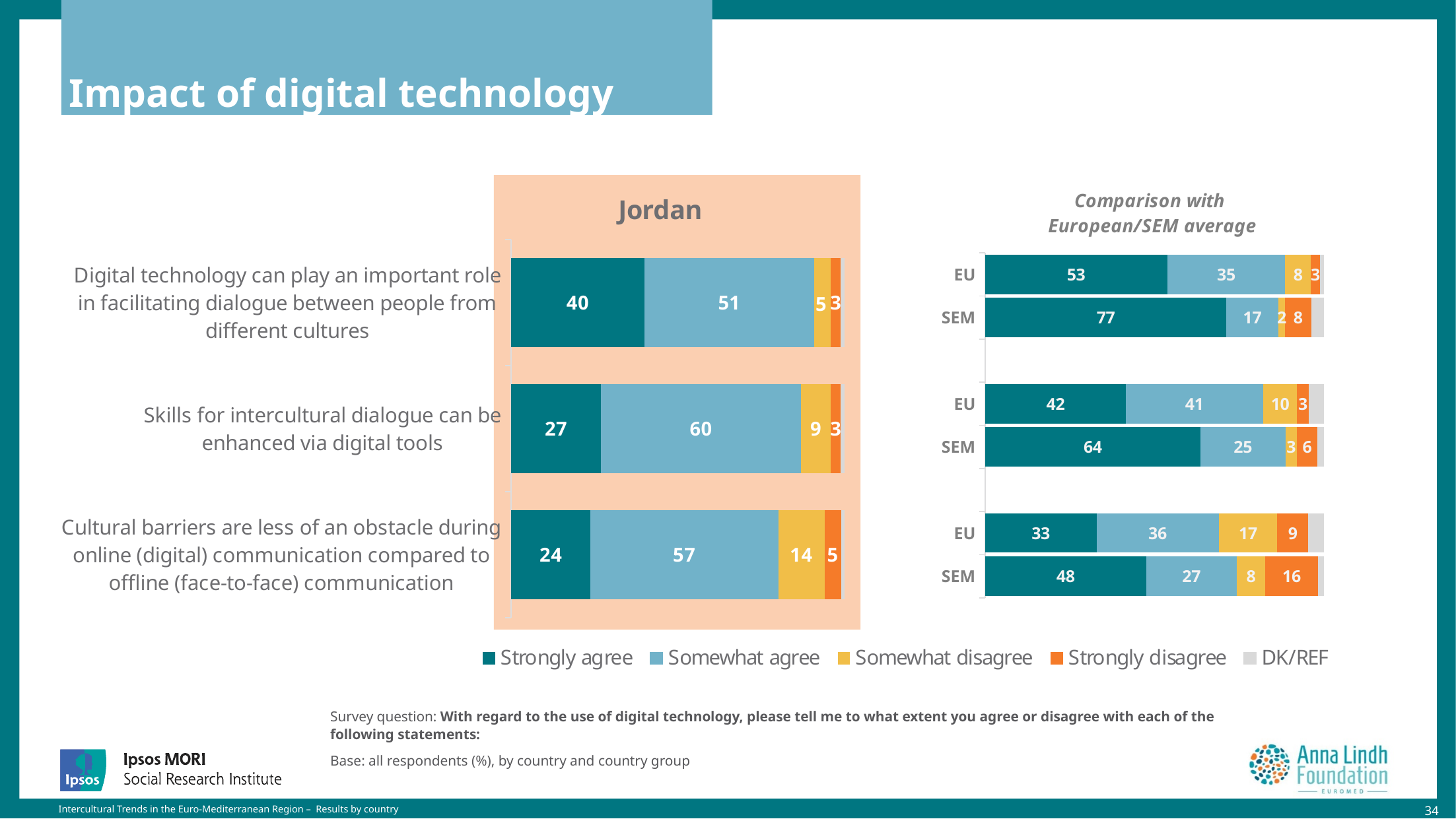
In the Jordan chart, what is the Somewhat disagree value for the statement about cultural barriers being less of an obstacle during online communication? 14 In the Jordan chart, what percentage strongly agree that digital technology can play an important role in facilitating dialogue between people from different cultures? 40 In the Jordan chart, which statement has the highest Strongly agree value? Digital technology can play an important role in facilitating dialogue between people from different cultures In the Comparison with European/SEM average chart, what is the EU Strongly disagree value for the third statement? 9 In the Jordan chart, what is the Somewhat agree value for 'Skills for intercultural dialogue can be enhanced via digital tools'? 60 In the Jordan chart, what is the difference between the Somewhat agree values for the cultural barriers statement and the digital technology dialogue statement? 6 In the Comparison with European/SEM average chart, for the third statement, which has the larger Strongly agree value, EU or SEM? SEM How many series does the legend list? 5 What kind of chart is the Jordan chart? Stacked bar chart How many statements are shown in the Jordan chart? 3 In the Comparison with European/SEM average chart, what is the SEM Strongly agree value for the first statement? 77